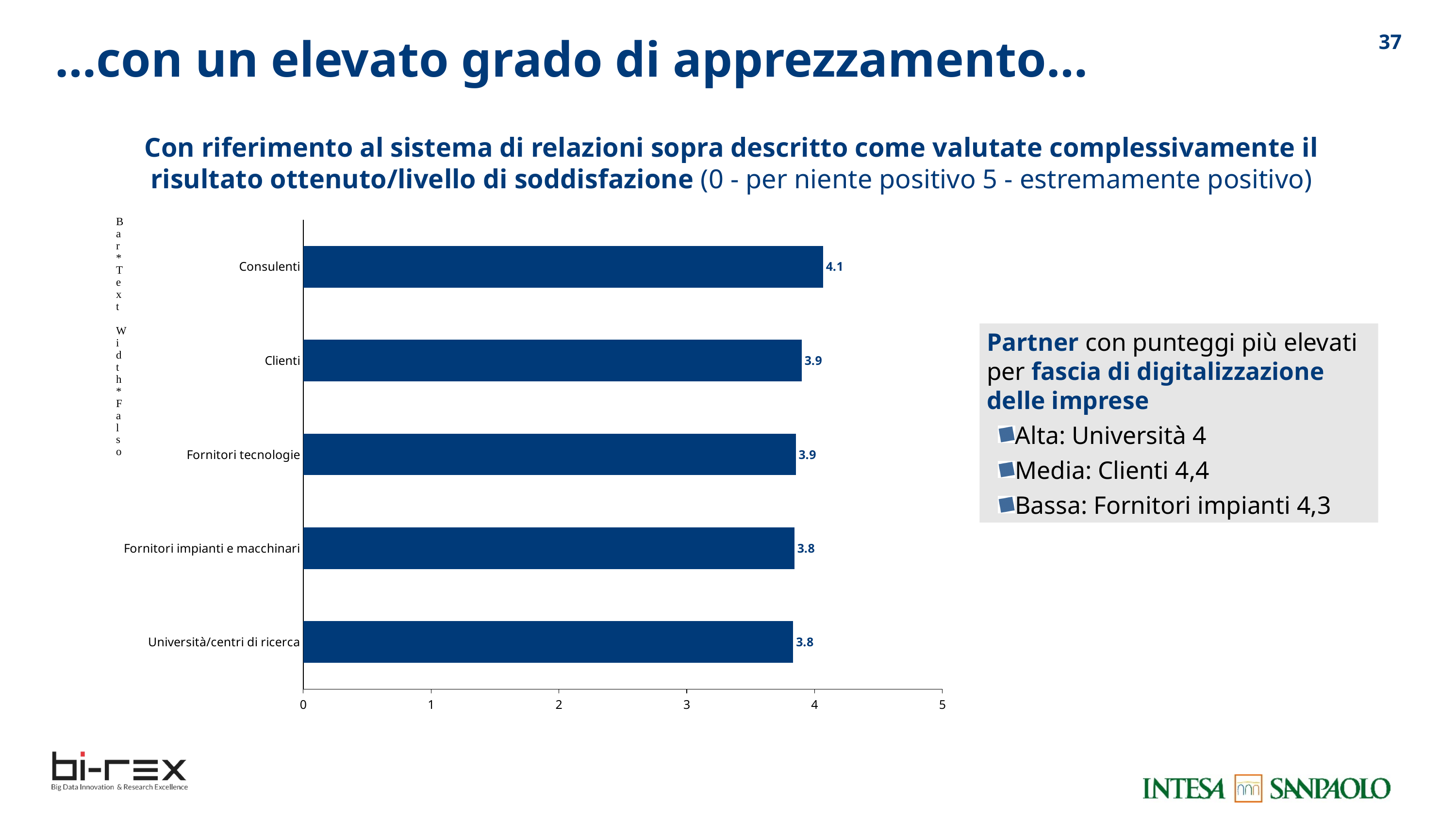
What is the value for Clienti? 3.9 What is the difference between the values for Consulenti and Università/centri di ricerca? 0.3 What is the value for Fornitori impianti e macchinari? 3.8 What is the difference between the values for Clienti and Fornitori impianti e macchinari? 0.1 What is the value for Consulenti? 4.1 How many categories are shown in the chart? 5 Is the value for Consulenti greater or less than 4? greater Which is larger, the value for Consulenti or the value for Fornitori impianti e macchinari? Consulenti What kind of chart is shown on the slide? bar chart What is the value for Università/centri di ricerca? 3.8 What is the value for Fornitori tecnologie? 3.9 Which category has the highest value? Consulenti